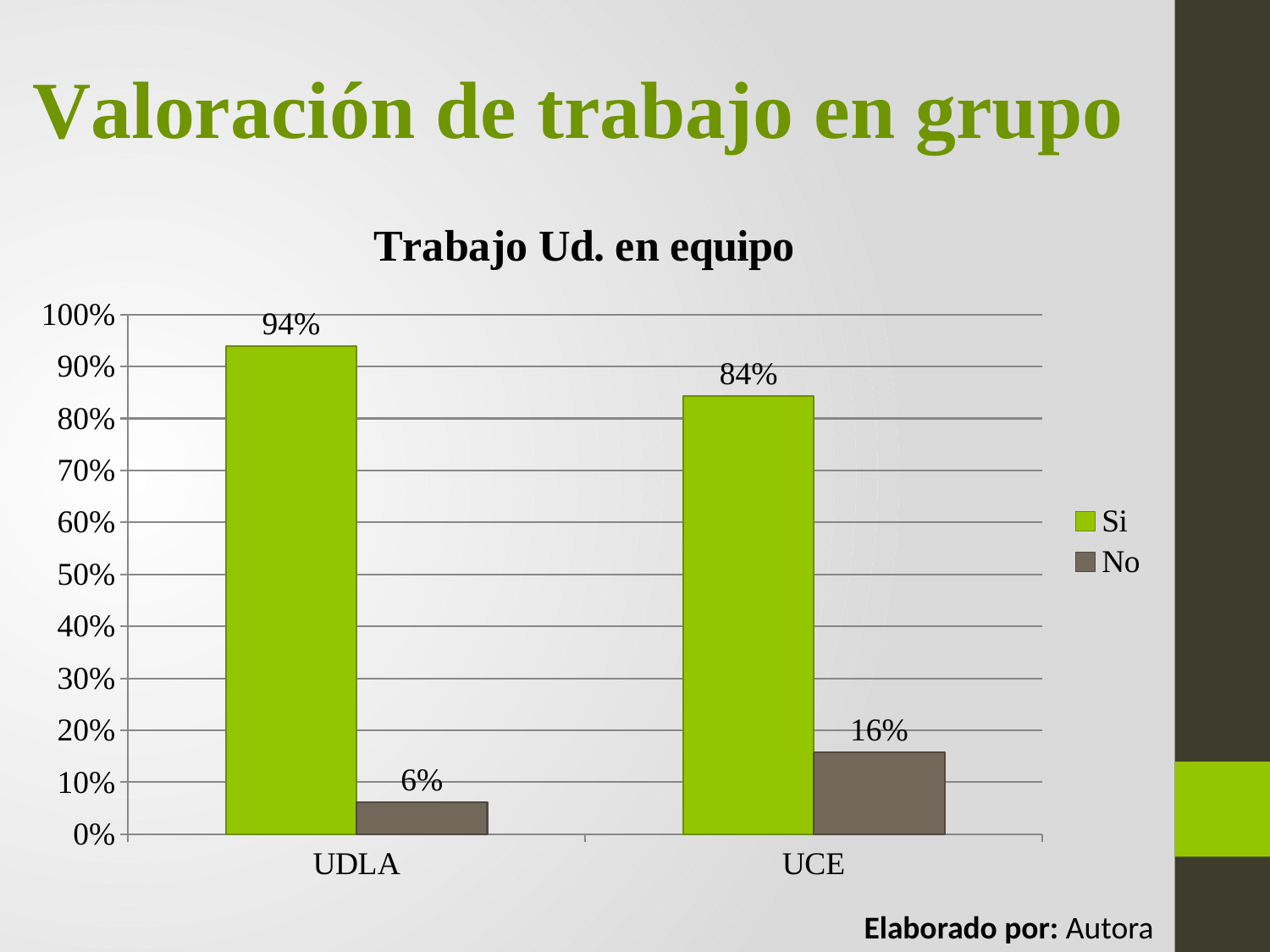
What is the value for Si at UCE? 84% What is the value for No at UDLA? 6% What is the value for No at UCE? 16% Which is larger, the No value for UCE or the No value for UDLA? UCE What is the value for Si at UDLA? 94% What is the difference between the Si values for UDLA and UCE? 10% How many series does the legend list? 2 Which category has the lowest No value? UDLA Is the value for Si at UCE greater or less than 90%? less How many categories are shown on the x axis? 2 What kind of chart is shown? bar chart Which category has the highest Si value? UDLA